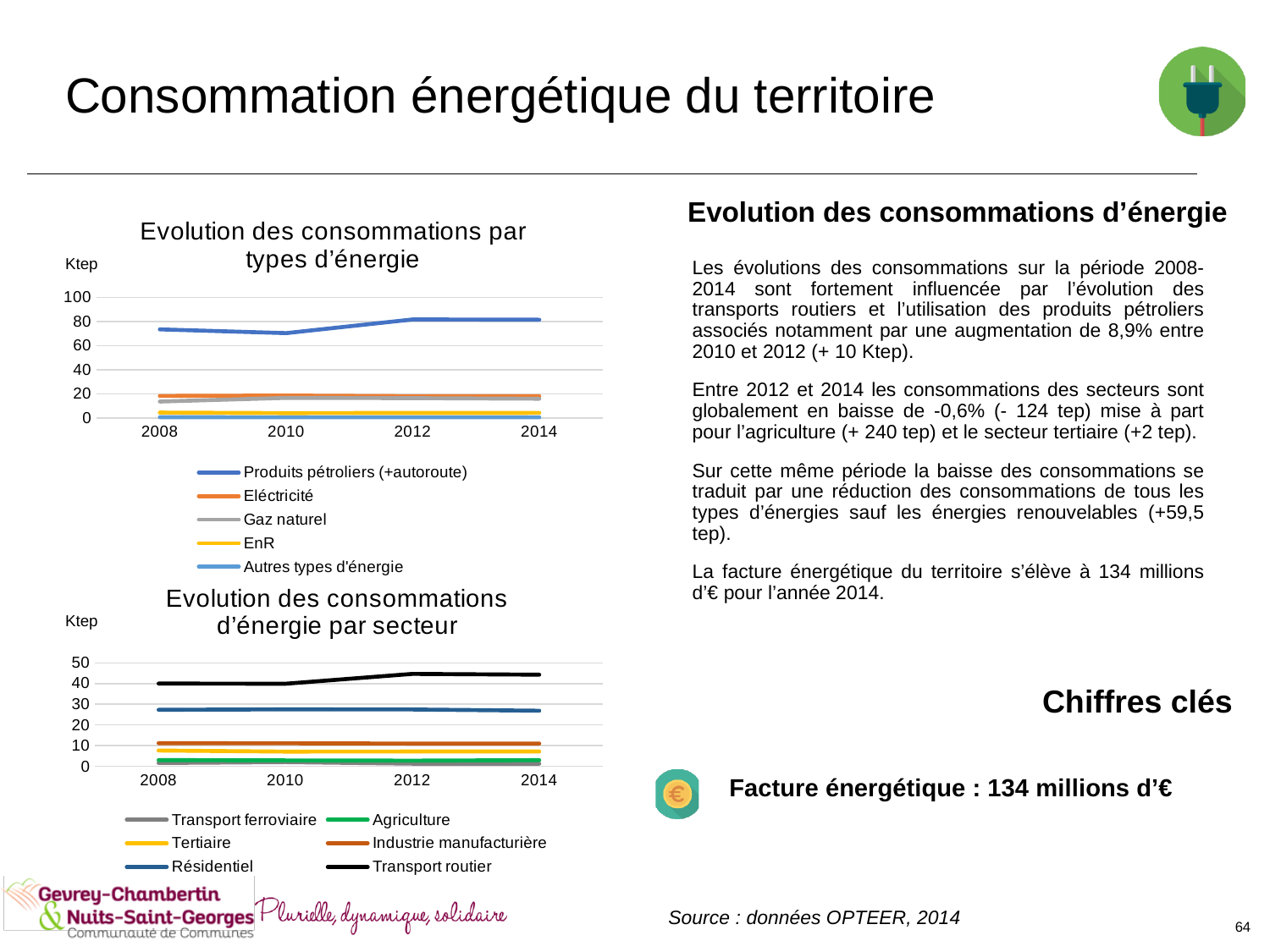
In the top chart 'Evolution des consommations par types d'énergie', is the value for Produits pétroliers (+autoroute) in 2014 greater or less than 60? greater In the bottom chart 'Evolution des consommations d'énergie par secteur', is the value for Résidentiel in 2008 greater or less than 30? less In the bottom chart 'Evolution des consommations d'énergie par secteur', which series has the highest values? Transport routier In the top chart 'Evolution des consommations par types d'énergie', does the Produits pétroliers (+autoroute) line rise or fall between 2010 and 2012? rise In the bottom chart 'Evolution des consommations d'énergie par secteur', which is larger in 2014: Résidentiel or Industrie manufacturière? Résidentiel In the bottom chart 'Evolution des consommations d'énergie par secteur', is the value for Transport routier in 2012 greater or less than 40? greater What kind of chart is the top chart titled 'Evolution des consommations par types d'énergie'? line chart How many series does the legend of the top chart 'Evolution des consommations par types d'énergie' list? 5 How many years are shown on the x axis of the top chart 'Evolution des consommations par types d'énergie'? 4 What unit is shown on the y axis of the top chart 'Evolution des consommations par types d'énergie'? Ktep How many series does the legend of the bottom chart 'Evolution des consommations d'énergie par secteur' list? 6 In the top chart 'Evolution des consommations par types d'énergie', which series has the highest values? Produits pétroliers (+autoroute)